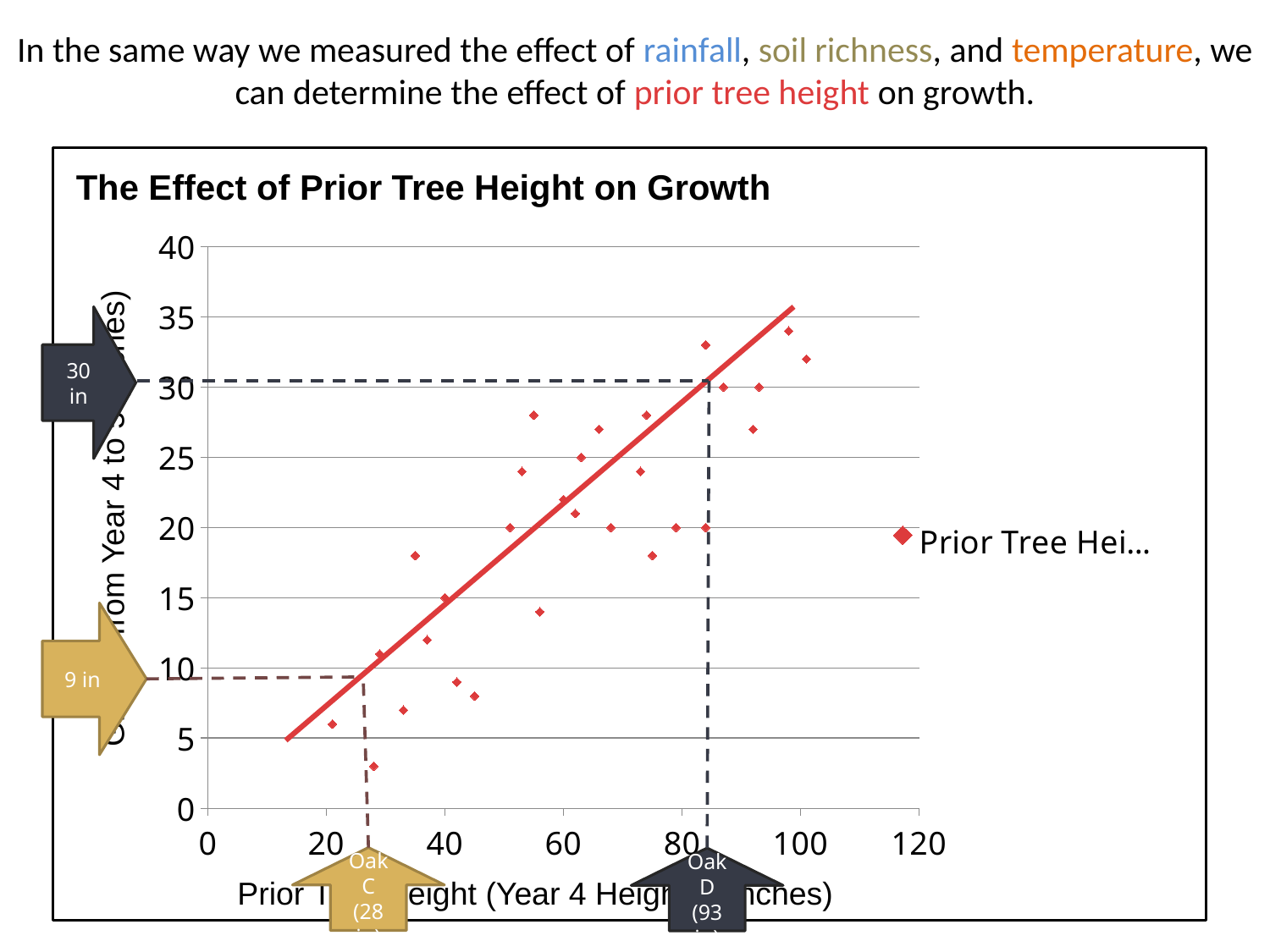
According to the annotation, what growth does the trend line give for Oak C (28 in)? 9 in What kind of chart is shown on the slide? scatter chart Do the plotted growth values generally rise or fall as prior tree height increases along the x axis? rise According to the annotation, what growth does the trend line give for Oak D (93 in)? 30 in Is the growth value of the lowest plotted point greater or less than 5? less What is the title of the chart? The Effect of Prior Tree Height on Growth What is the difference between the annotated growth values for Oak D and Oak C? 21 in How many series does the chart's legend list? 1 What is the highest tick value shown on the x axis? 120 What is the highest value shown on the y axis? 40 Which annotated tree has the larger predicted growth, Oak C or Oak D? Oak D Is the growth value of the highest plotted point greater or less than 30? greater